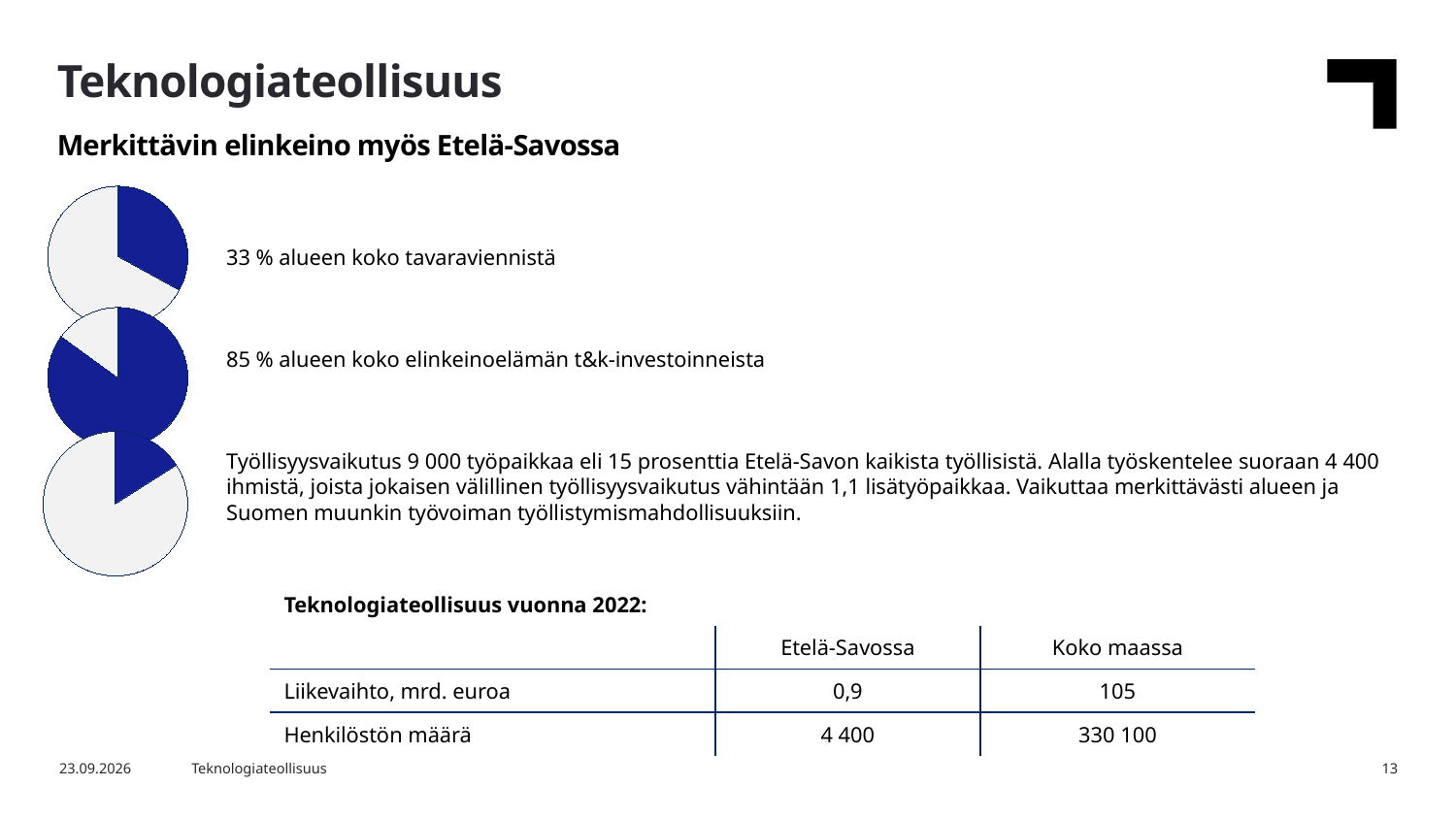
What colour is the highlighted slice in each of the pie charts? blue In the top pie chart, is the blue slice greater or less than half of the pie? less Which of the three pie charts has the largest blue slice? the middle one In the bottom pie chart, what share of all employed people in Etelä-Savo does the blue slice represent? 15 prosenttia What kind of charts are the three charts on the left side of the slide? pie charts In the middle pie chart, is the blue slice greater or less than half of the pie? greater In the top pie chart, what share of the region's total goods exports (tavaravienti) does the blue slice represent? 33 % How many pie charts are shown on the slide? 3 In the middle pie chart, what share of the region's business R&D investments (t&k-investoinnit) does the blue slice represent? 85 % By how many percentage points does the blue share in the middle pie chart (85 %) exceed the blue share in the top pie chart (33 %)? 52 Is the blue slice larger in the top pie chart or in the bottom pie chart? the top pie chart Which of the three pie charts has the smallest blue slice? the bottom one